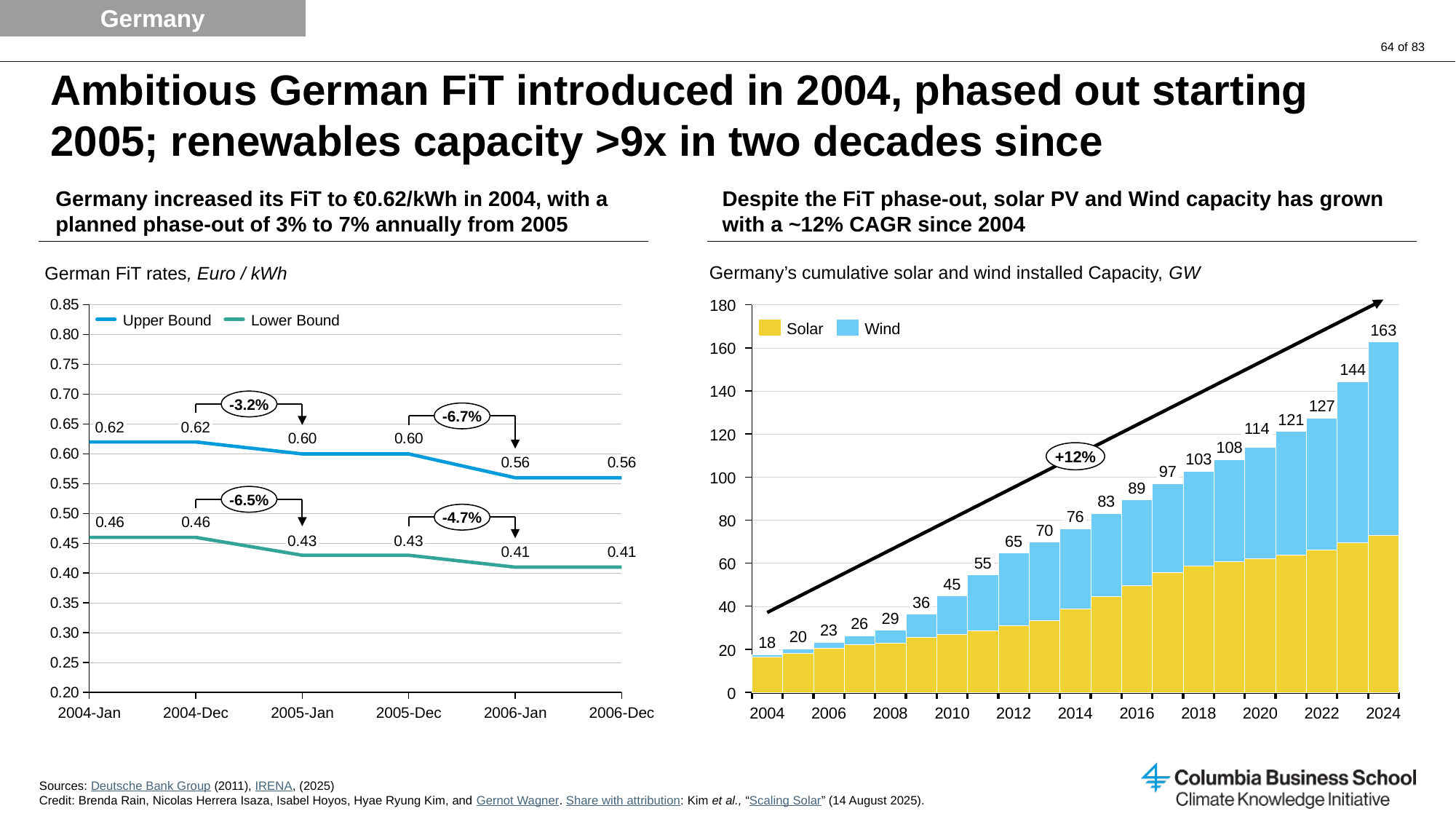
In the cumulative solar and wind installed capacity chart, what kind of chart is shown? stacked bar chart In the German FiT rates chart, what is the Upper Bound value at 2004-Jan? 0.62 In the cumulative solar and wind installed capacity chart, which year has the highest total? 2024 In the cumulative solar and wind installed capacity chart, what is the total labelled for 2024? 163 In the German FiT rates chart, how many series does the legend list? 2 In the cumulative solar and wind installed capacity chart, how many years (bars) are plotted? 21 In the German FiT rates chart, what is the Lower Bound value at 2006-Dec? 0.41 In the German FiT rates chart, what percentage change is labelled for the Upper Bound drop between 2005-Dec and 2006-Jan? -6.7% In the cumulative solar and wind installed capacity chart, what is the difference between the 2024 total and the 2022 total? 36 In the German FiT rates chart, do the Upper Bound values rise or fall from 2004-Jan to 2006-Dec? fall In the cumulative solar and wind installed capacity chart, what is the total labelled for 2004? 18 In the German FiT rates chart, what is the difference between the Upper Bound and Lower Bound values at 2005-Jan? 0.17